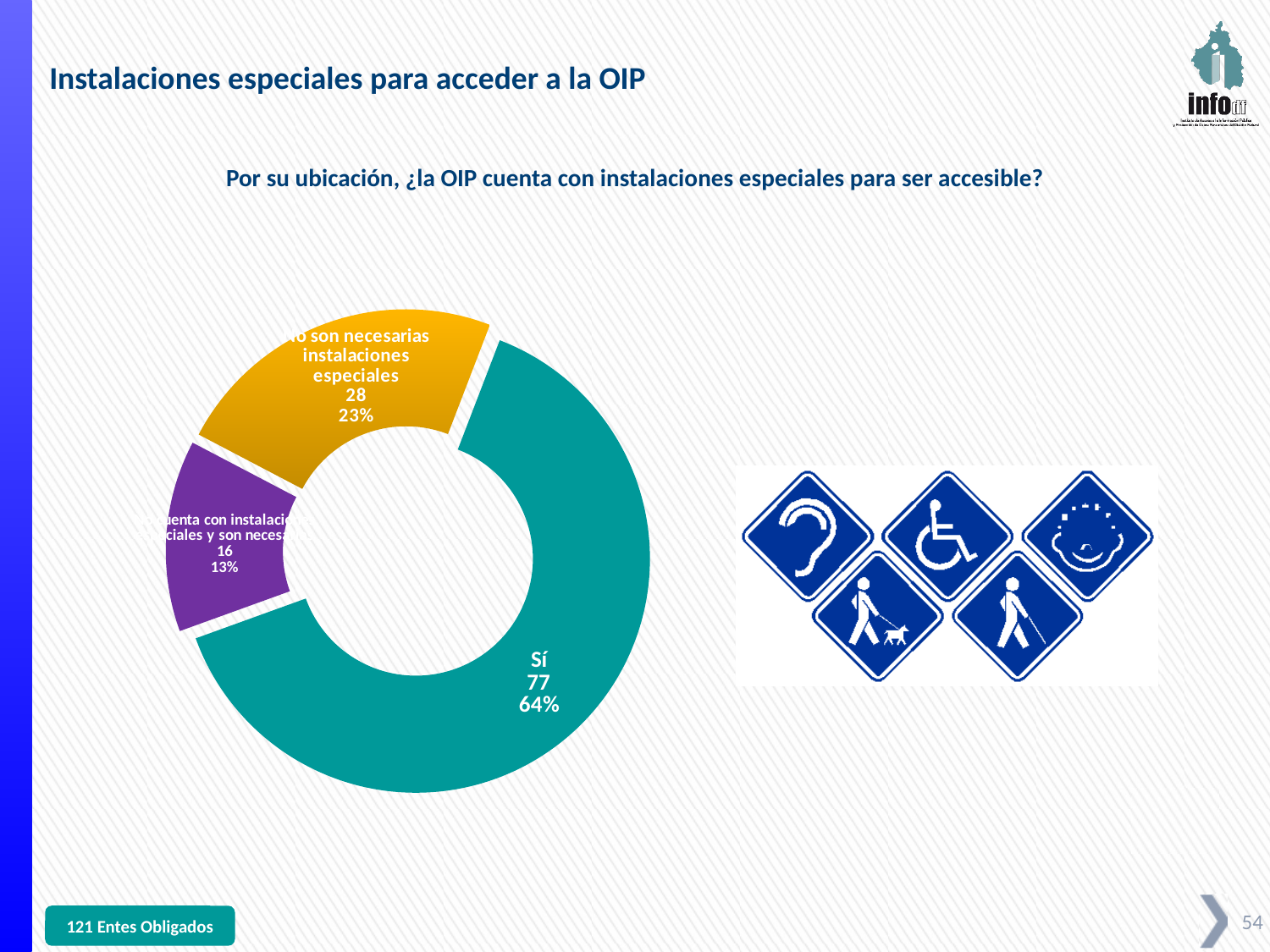
What is the total number of entities across all three slices of the pie? 121 How many slices does the pie chart have? 3 What percentage is shown for the "No son necesarias instalaciones especiales" slice? 23% How many entities fall in the "No son necesarias instalaciones especiales" slice? 28 What count is shown on the purple slice of the pie? 16 What percentage is shown on the purple slice of the pie? 13% What is the count shown on the smallest slice of the pie? 16 What percentage of the pie does the "Sí" slice represent? 64% How many more entities answered "Sí" than "No son necesarias instalaciones especiales"? 49 Which slice of the pie is the largest? Sí How many entities answered "Sí"? 77 What kind of chart is shown on the slide? pie chart (donut)